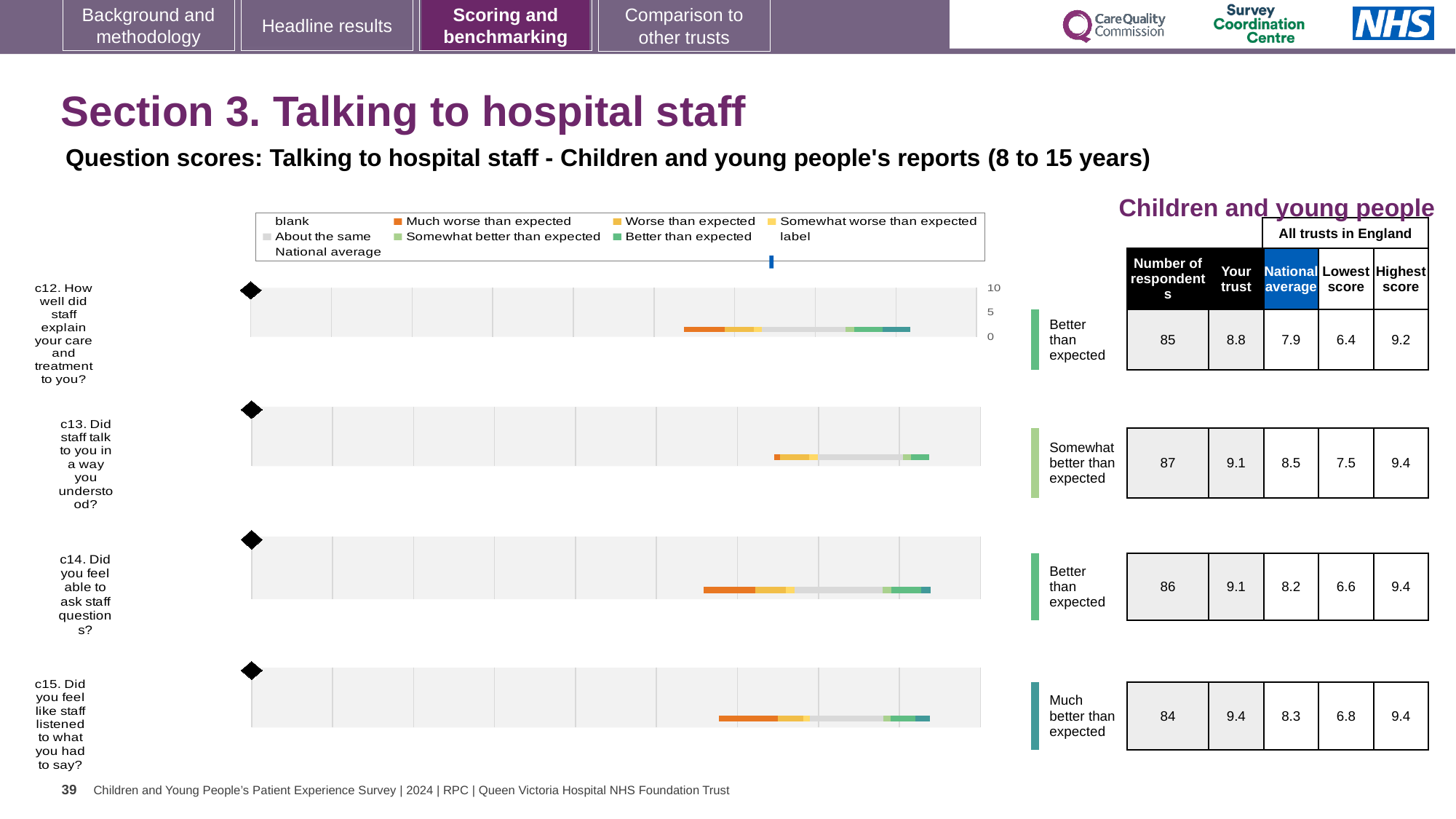
What is the national average score for c15 (Did you feel like staff listened to what you had to say?)? 8.3 Which question has the lowest 'Your trust' score? c12 How many survey questions (chart rows) are plotted on the slide? 4 What benchmark category is shown for c13 (Did staff talk to you in a way you understood?)? Somewhat better than expected What is the difference between the 'Your trust' score and the national average for c12? 0.9 For c13, which is larger: the 'Your trust' score or the national average? Your trust What is the highest score among all trusts in England for c12? 9.2 Which question has the highest 'Your trust' score? c15 What is the 'Your trust' score for c12 (How well did staff explain your care and treatment to you?)? 8.8 What colour does the legend use for 'Much worse than expected'? Orange How many respondents answered c14 (Did you feel able to ask staff questions?)? 86 What kind of chart is used to show the question scores for c12 to c15? Bar chart